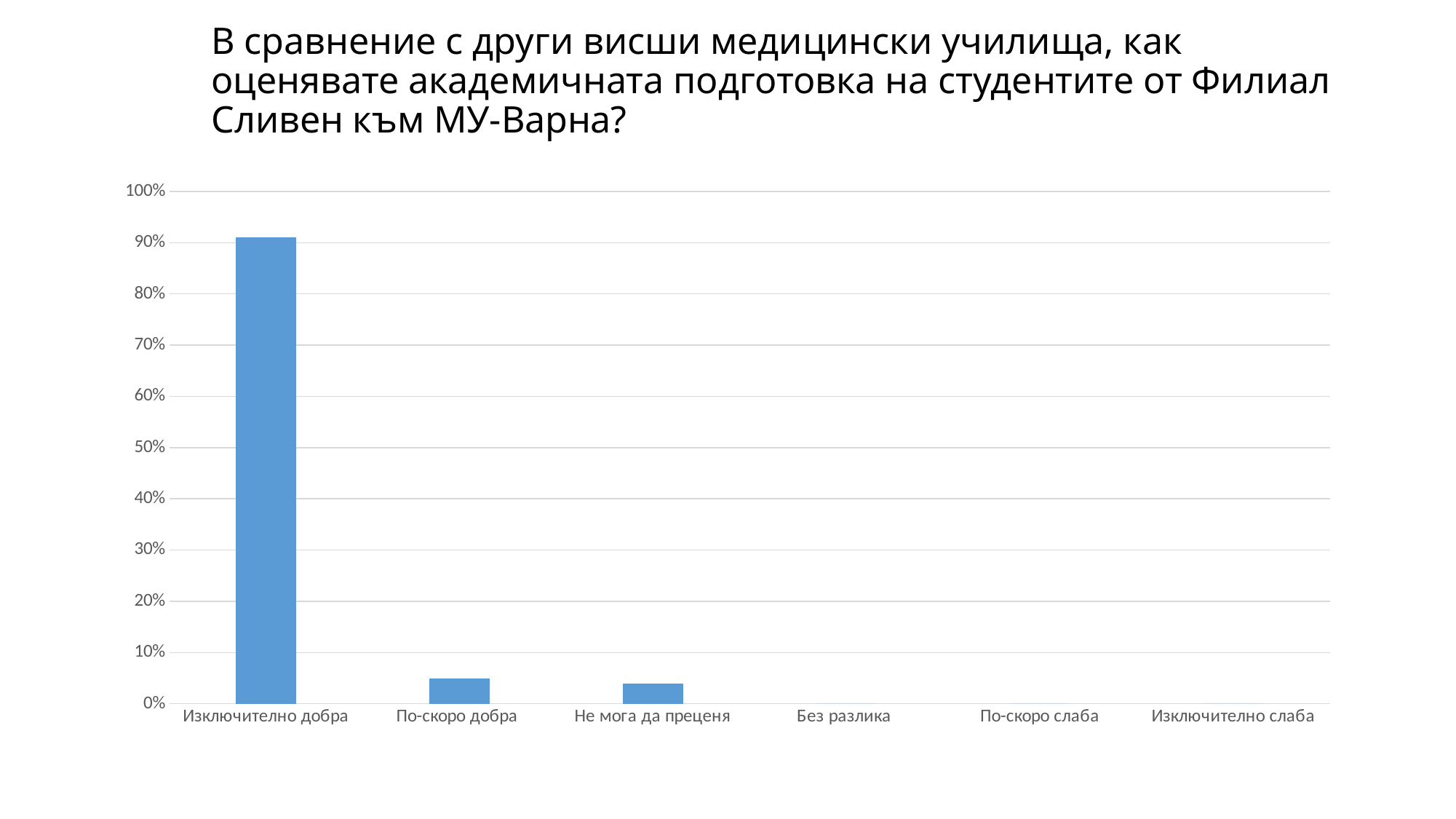
Is the value for По-скоро добра greater or less than 10%? less Is the value for Не мога да преценя greater or less than 10%? less Is the value for Изключително добра greater or less than 80%? greater Do the values generally rise or fall moving from left to right along the x axis? fall Which is larger, the value for Изключително добра or the value for По-скоро добра? Изключително добра Which is larger, the value for Изключително добра or the value for Не мога да преценя? Изключително добра What kind of chart is shown on the slide? bar chart Which category has the highest value in the chart? Изключително добра How many categories are shown on the x axis of the chart? 6 What is the highest tick value shown on the vertical axis of the chart? 100% What colour are the bars in the chart? blue